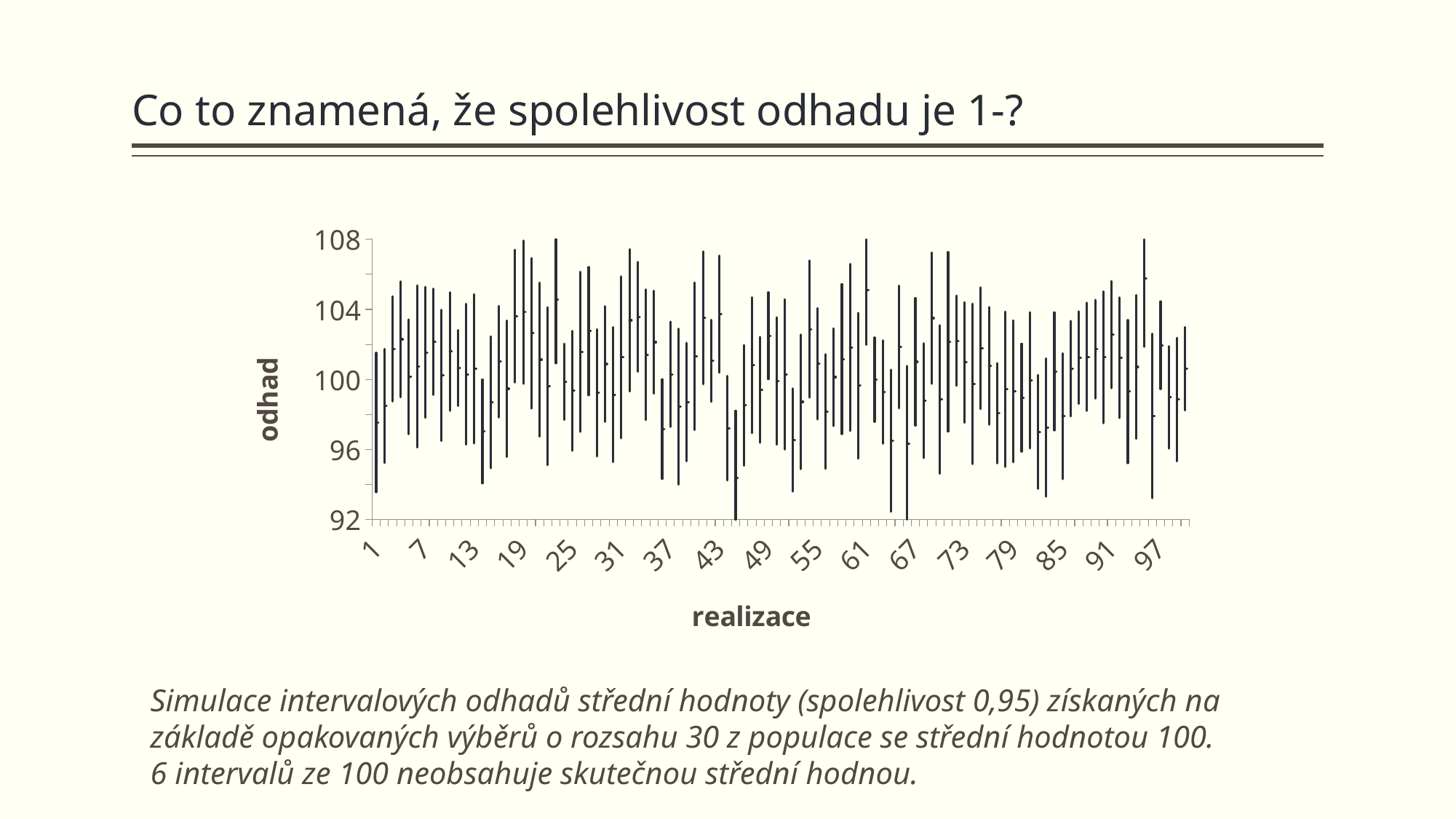
Is the lower end of the interval for realization 1 greater or less than 96? less Is the upper end of the interval for realization 1 greater or less than 100? greater What is the title of the vertical axis of the chart? odhad How many realizations (intervals) are plotted on the chart? 100 According to the slide, how many of the 100 intervals do not contain the true mean? 6 What kind of chart is shown on the slide? high-low line chart (interval chart)